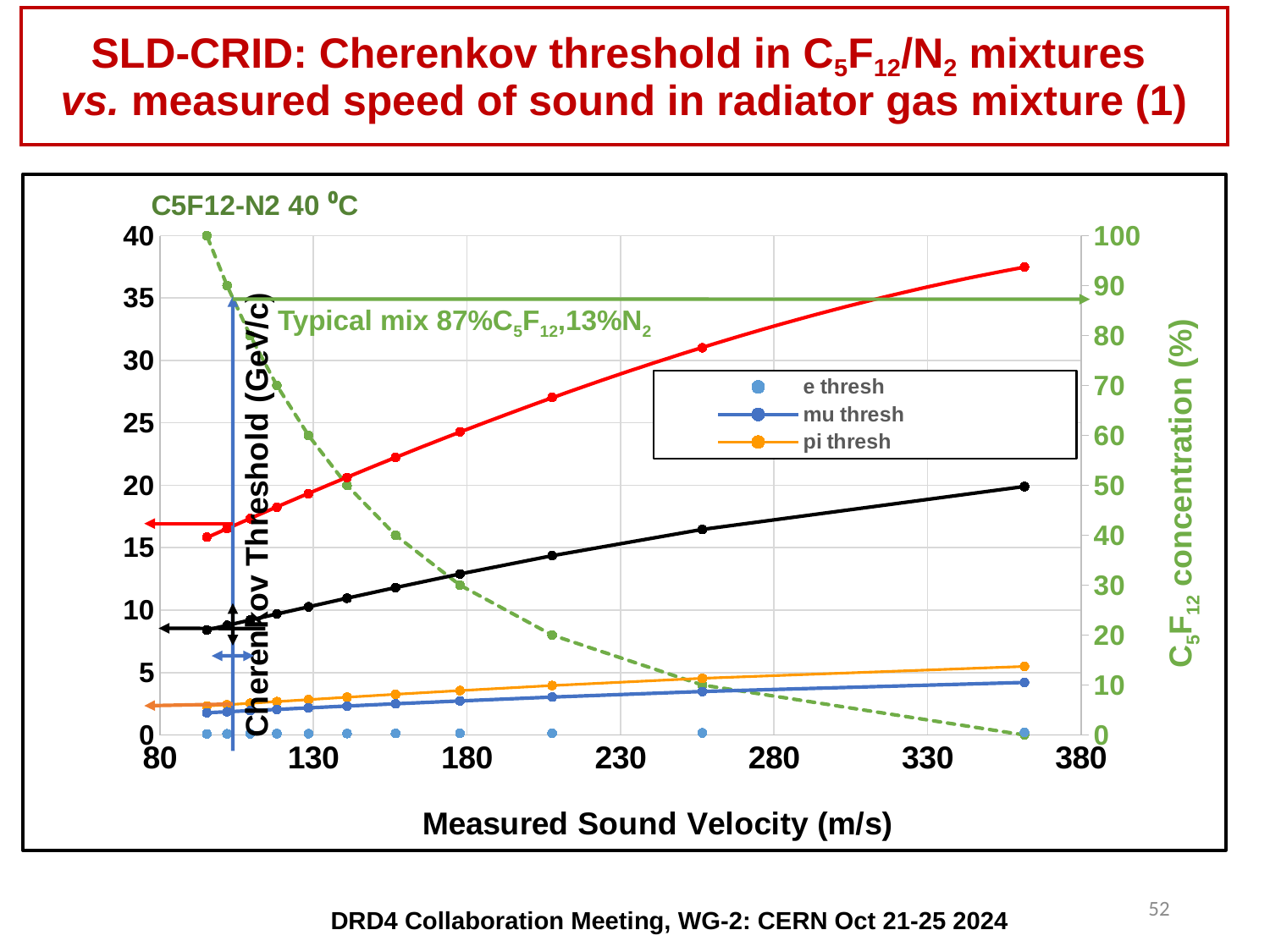
Does the pi thresh series rise or fall as measured sound velocity increases? rise What is the title of the right-hand y axis? C5F12 concentration (%) What kind of chart is shown on the slide? line chart At the highest sound velocity (about 360 m/s), which is larger: pi thresh or mu thresh? pi thresh How many series does the legend list? 3 Does the green dashed C5F12 concentration curve rise or fall as measured sound velocity increases? fall Is the C5F12 concentration at the lowest sound velocity (about 97 m/s) greater or less than 90%? greater Is the e thresh value at the highest sound velocity (about 360 m/s) greater or less than 5 GeV/c? less What is the title of the x axis? Measured Sound Velocity (m/s) Is the pi thresh value at the highest sound velocity (about 360 m/s) greater or less than 10 GeV/c? less Does the mu thresh series rise or fall as measured sound velocity increases? rise